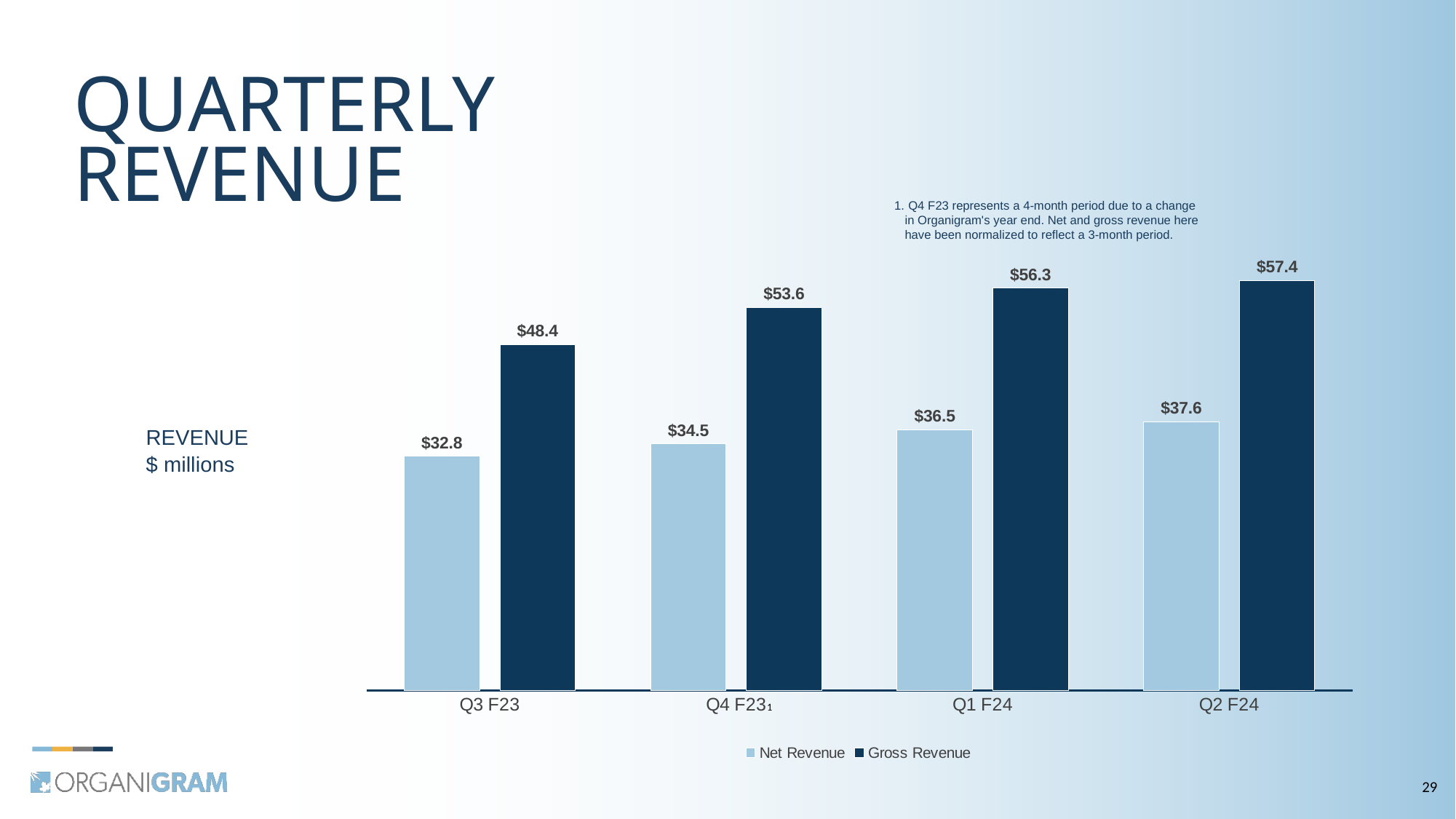
Does Net Revenue rise or fall from Q3 F23 to Q2 F24? Rise What is the Net Revenue for Q3 F23? $32.8 By how much did Gross Revenue increase from Q3 F23 to Q4 F23? $5.2 How many quarters are shown on the x axis? 4 What is the Gross Revenue for Q4 F23? $53.6 Which quarter has the highest Gross Revenue? Q2 F24 What is the Gross Revenue for Q1 F24? $56.3 Which is larger, Net Revenue in Q1 F24 or Net Revenue in Q4 F23? Net Revenue in Q1 F24 What kind of chart is shown on the slide? Bar chart What is the difference between Gross Revenue and Net Revenue in Q2 F24? $19.8 Which quarter has the lowest Net Revenue? Q3 F23 How many series does the legend list? 2